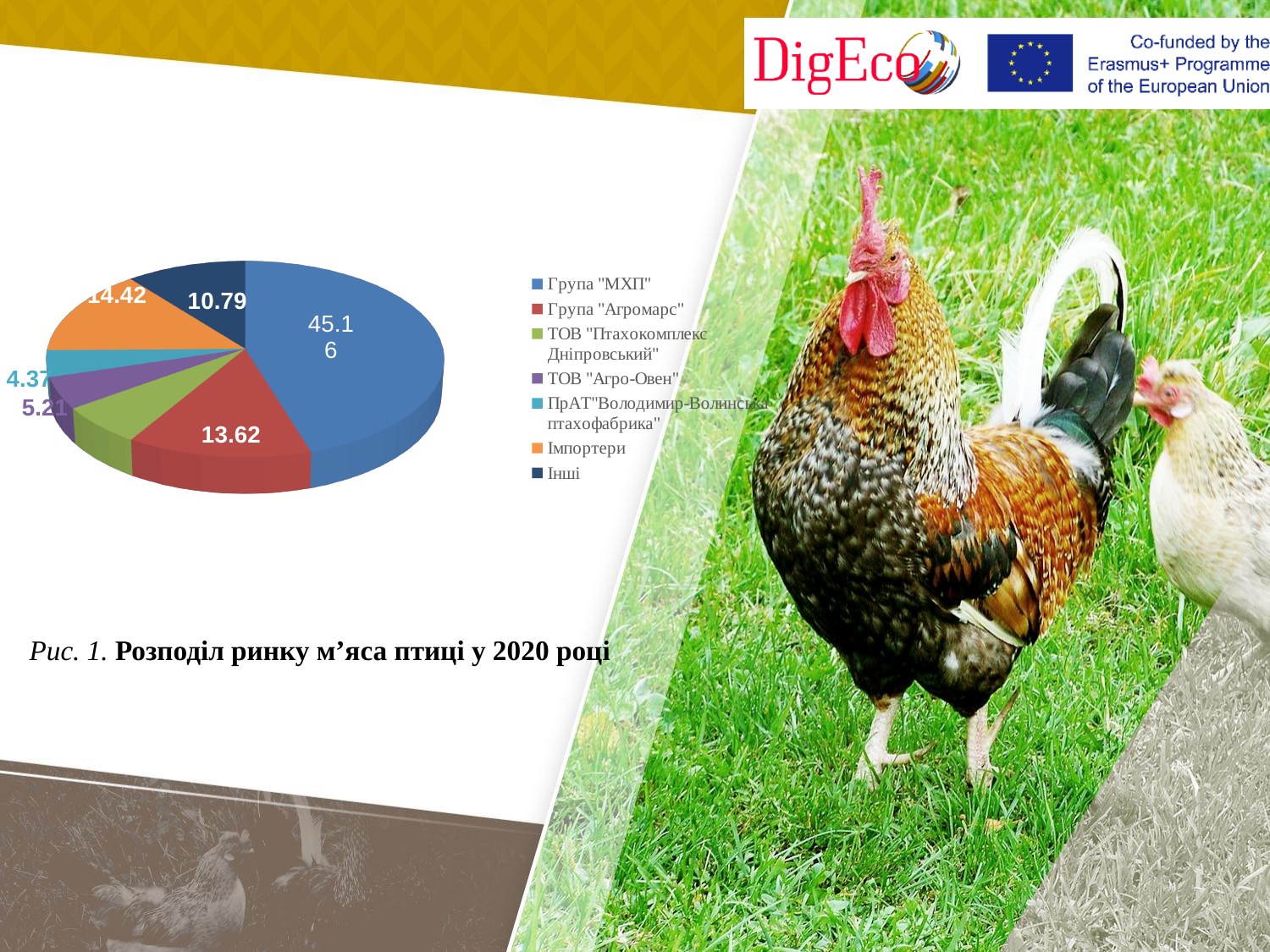
What is the value shown for Група "Агромарс"? 13.62 Which category has the largest slice in the pie chart? Група "МХП" What is the value shown for Імпортери? 14.42 What is the difference between the values for Група "МХП" and Група "Агромарс"? 31.54 How many entries does the legend of the pie chart list? 7 What is the value shown for Інші? 10.79 Which is larger, the value for Імпортери or the value for Група "Агромарс"? Імпортери What is the difference between the values for Імпортери and Інші? 3.63 What is the caption of the figure below the pie chart? Рис. 1. Розподіл ринку м’яса птиці у 2020 році What kind of chart is shown on the slide? pie chart What is the value shown for Група "МХП"? 45.16 What colour is the slice for Група "МХП" in the pie chart? blue